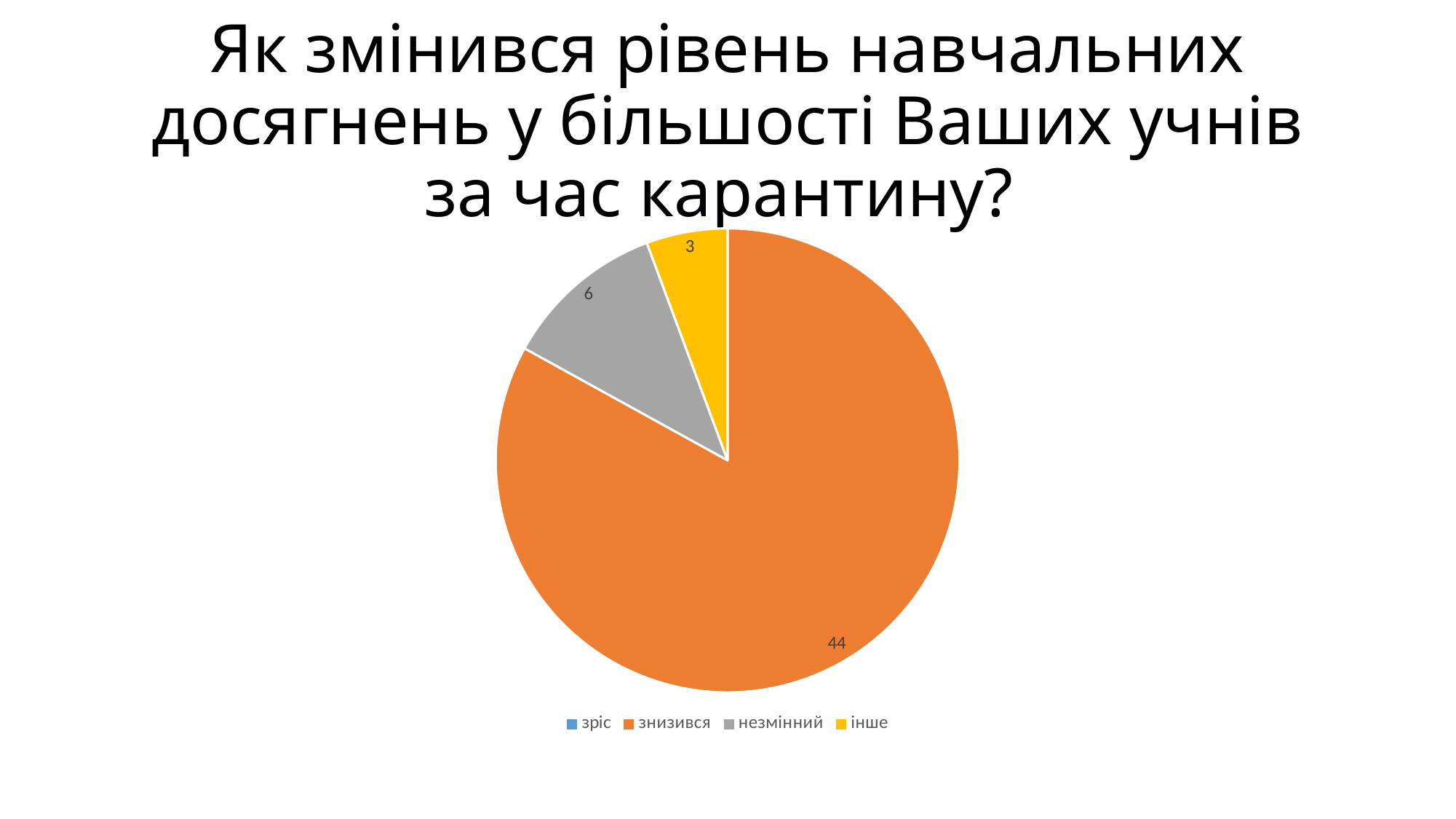
Which is larger, the value for "незмінний" or the value for "інше"? незмінний How many entries does the legend list? 4 Which category has the largest slice of the pie? знизився Which of the labelled slices has the smallest value? інше What is the difference between the values for "знизився" and "незмінний"? 38 What is the value for the "знизився" slice? 44 What is the value for the "незмінний" slice? 6 What kind of chart is shown on the slide? pie chart What colour is the "знизився" slice? orange What is the value for the "інше" slice? 3 What is the difference between the values for "незмінний" and "інше"? 3 Which legend entry is shown in yellow? інше